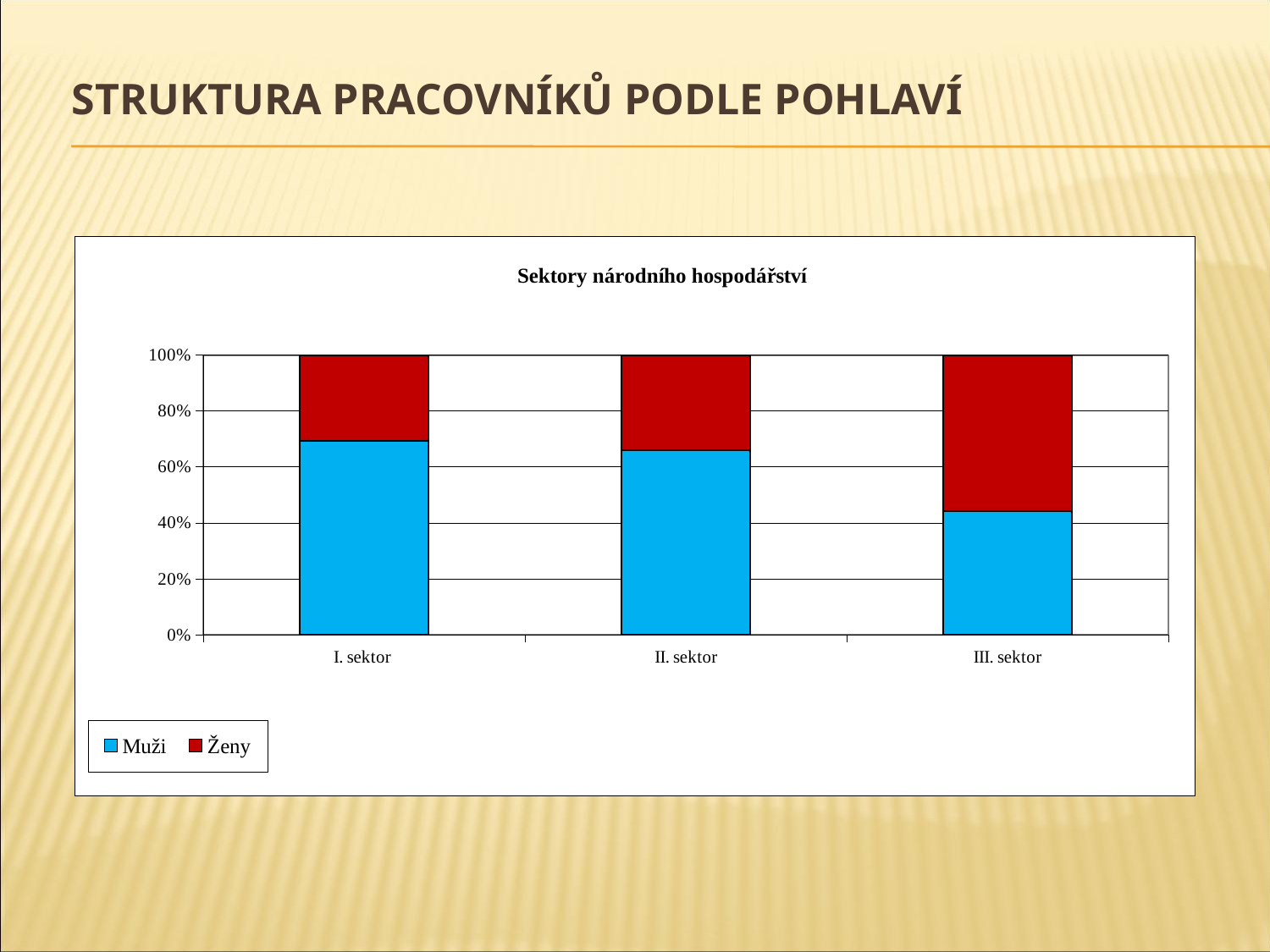
Which sector has the lowest share of Muži? III. sektor In III. sektor, which is larger, the share of Muži or the share of Ženy? Ženy What is the title of the chart? Sektory národního hospodářství Which sector has the highest share of Ženy? III. sektor How many sectors (categories) are shown on the x axis? 3 How many series does the legend list? 2 Which series are listed in the legend? Muži, Ženy What is the total height of the stacked bar for I. sektor? 100% Is the value for Muži in I. sektor greater or less than 60%? greater Is the value for Muži in III. sektor greater or less than 60%? less Is the value for Muži in II. sektor greater or less than 80%? less What kind of chart is shown on the slide? stacked bar chart